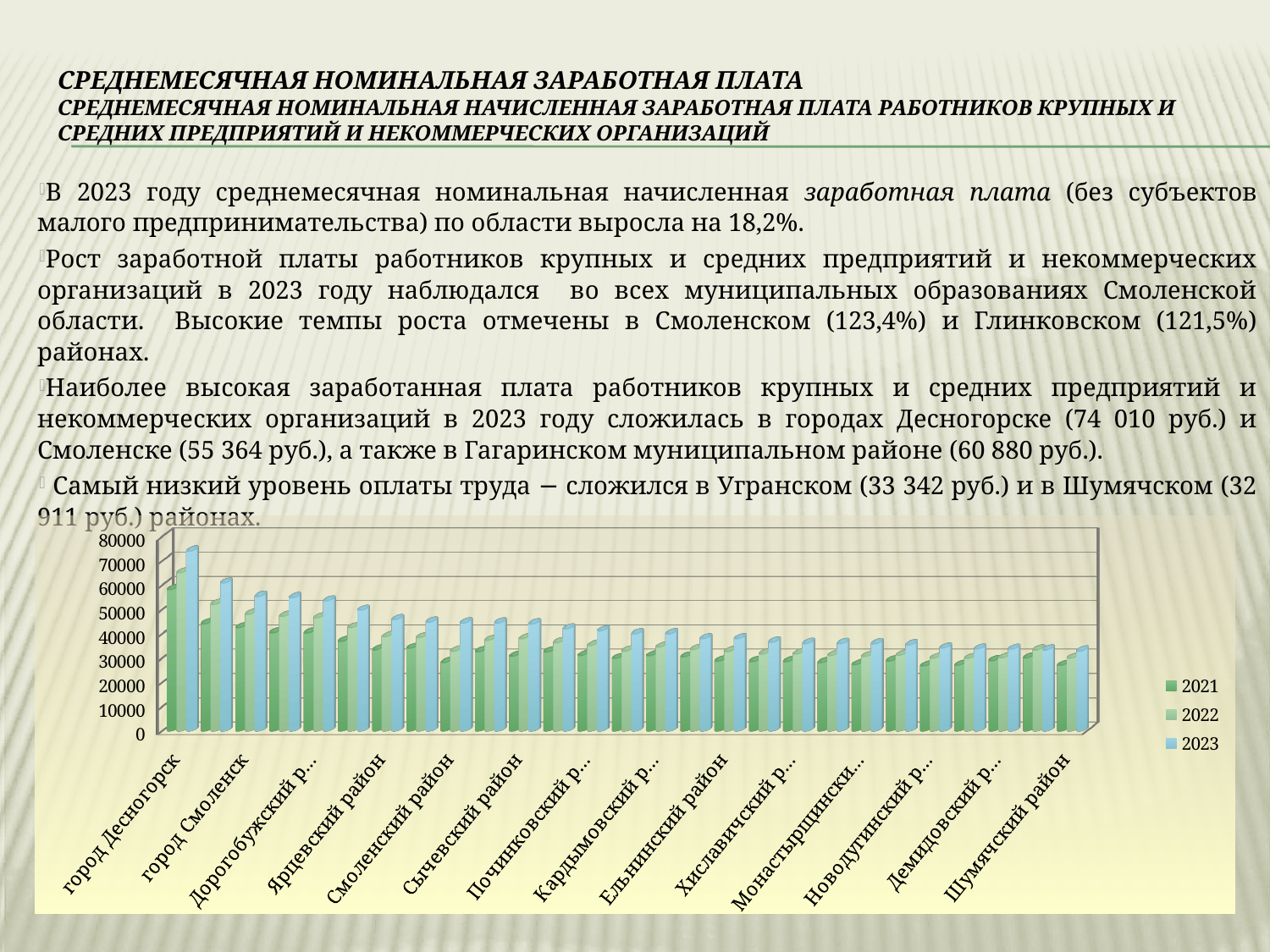
Is the 2023 value for город Десногорск greater or less than 70000? greater Is the 2023 value for Шумячский район greater or less than 40000? less Is the 2021 value for Шумячский район greater or less than 40000? less Which category has the highest 2023 value in the chart? город Десногорск Which years are listed in the chart legend? 2021, 2022, 2023 Do the 2023 values generally rise or fall moving from left to right along the x axis? fall Which series is shown in blue in the chart? 2023 How many series does the chart legend list? 3 What kind of chart is shown on the slide? bar chart Which is larger, the 2023 value for Ярцевский район or the 2023 value for Шумячский район? Ярцевский район Which is larger, the 2023 value for город Десногорск or the 2023 value for город Смоленск? город Десногорск